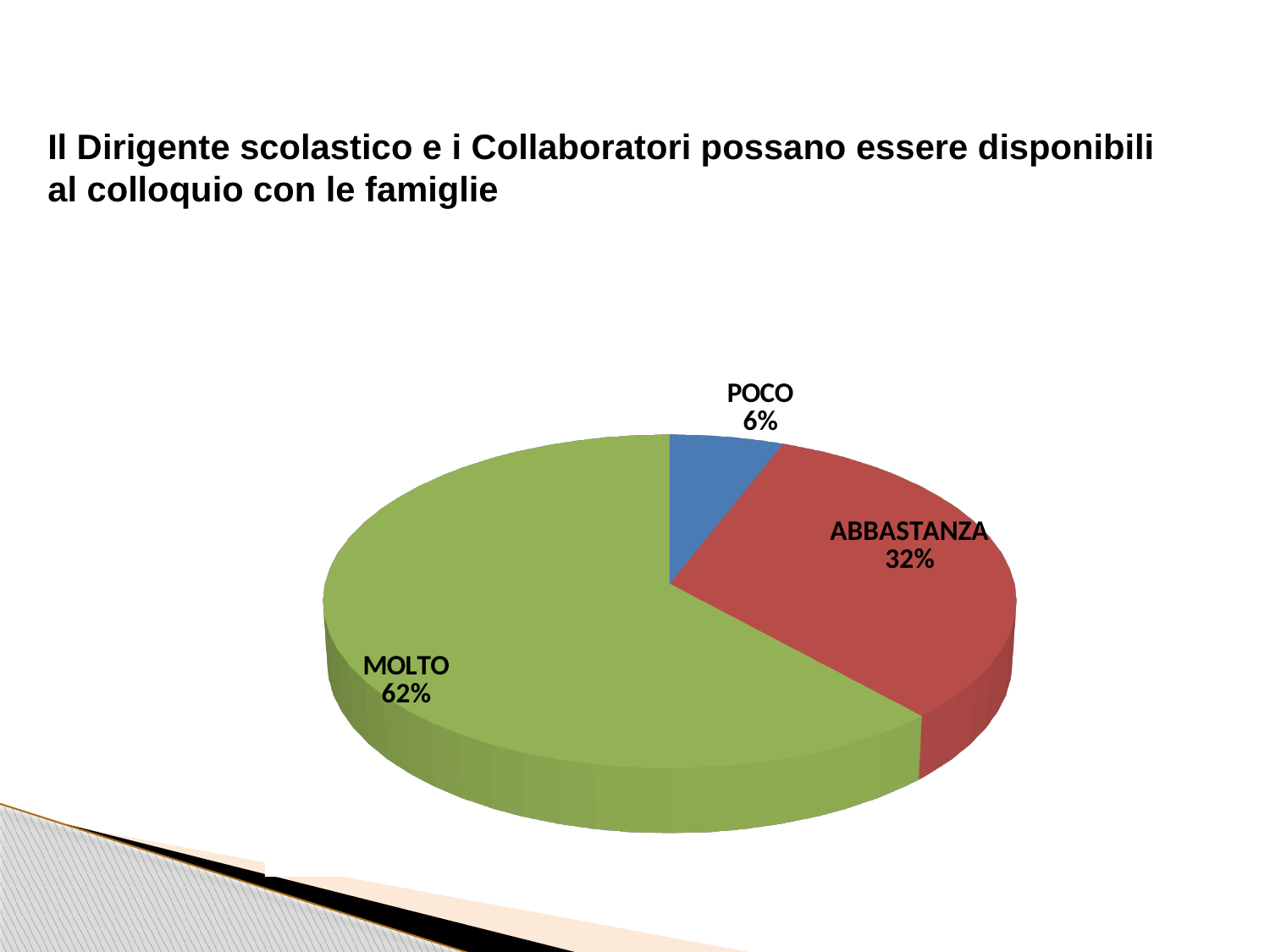
What percentage is shown for POCO? 6% What kind of chart is shown on the slide? pie chart What colour is the MOLTO slice? green Which is larger, the share for ABBASTANZA or the share for POCO? ABBASTANZA What percentage is shown for ABBASTANZA? 32% What colour is the POCO slice? blue What is the difference in percentage points between MOLTO and ABBASTANZA? 30 How many slices does the pie chart have? 3 Which category has the largest share of the pie? MOLTO Which category has the smallest share of the pie? POCO What percentage is shown for MOLTO? 62% What is the difference in percentage points between ABBASTANZA and POCO? 26